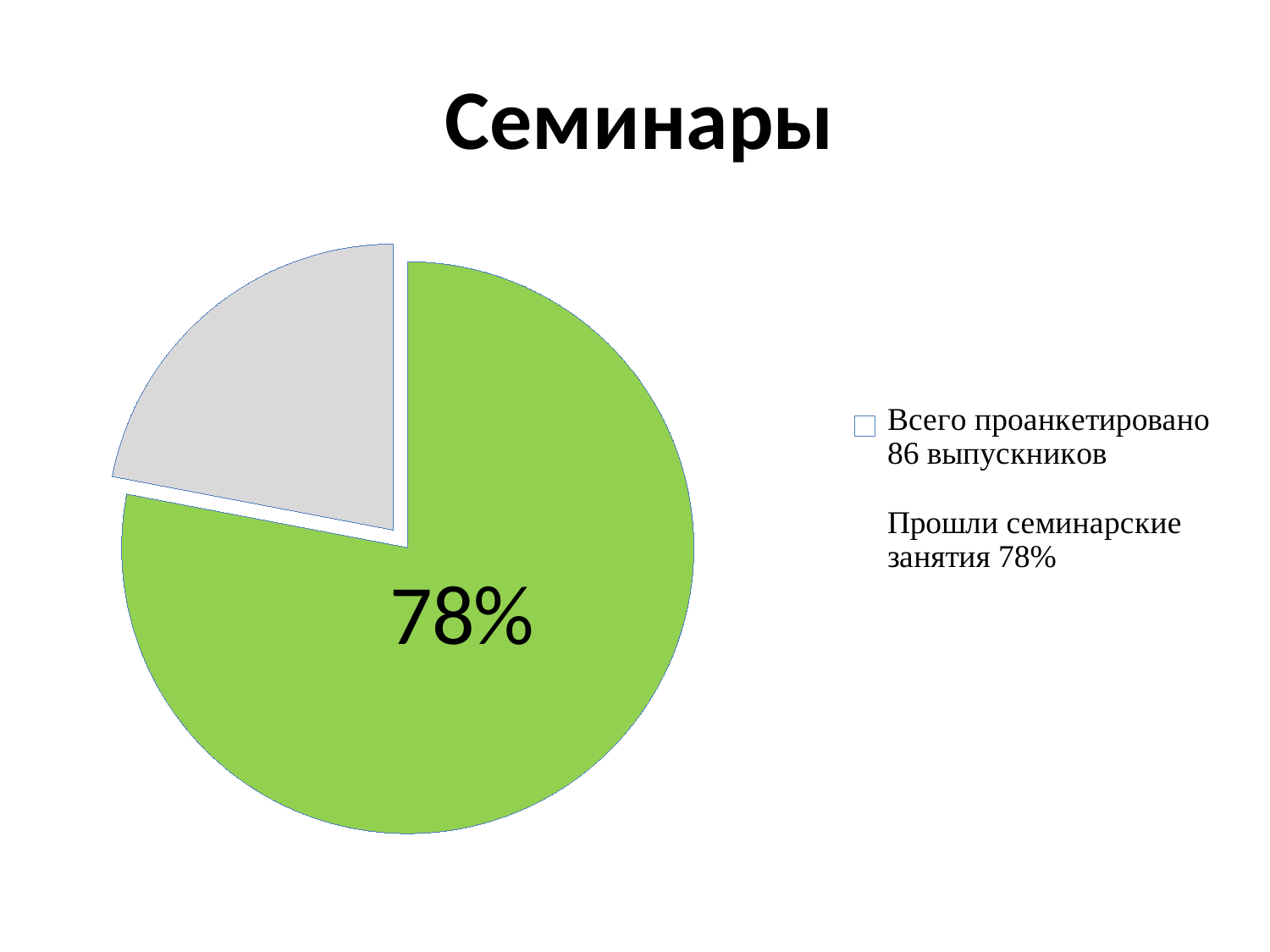
Is the green slice of the pie chart more or less than half of the pie? more What kind of chart is shown on the slide? pie chart Which slice of the pie chart is the largest? the green slice What share of the pie does the green slice represent? 78% What percentage is printed on the green slice of the pie chart? 78% What is the title of the chart on the slide? Семинары Which slice of the pie chart is larger, the green one or the grey one? the green one Which slice of the pie chart is the smallest? the grey slice According to the text next to the chart, how many graduates were surveyed in total? 86 выпускников How many slices does the pie chart have? 2